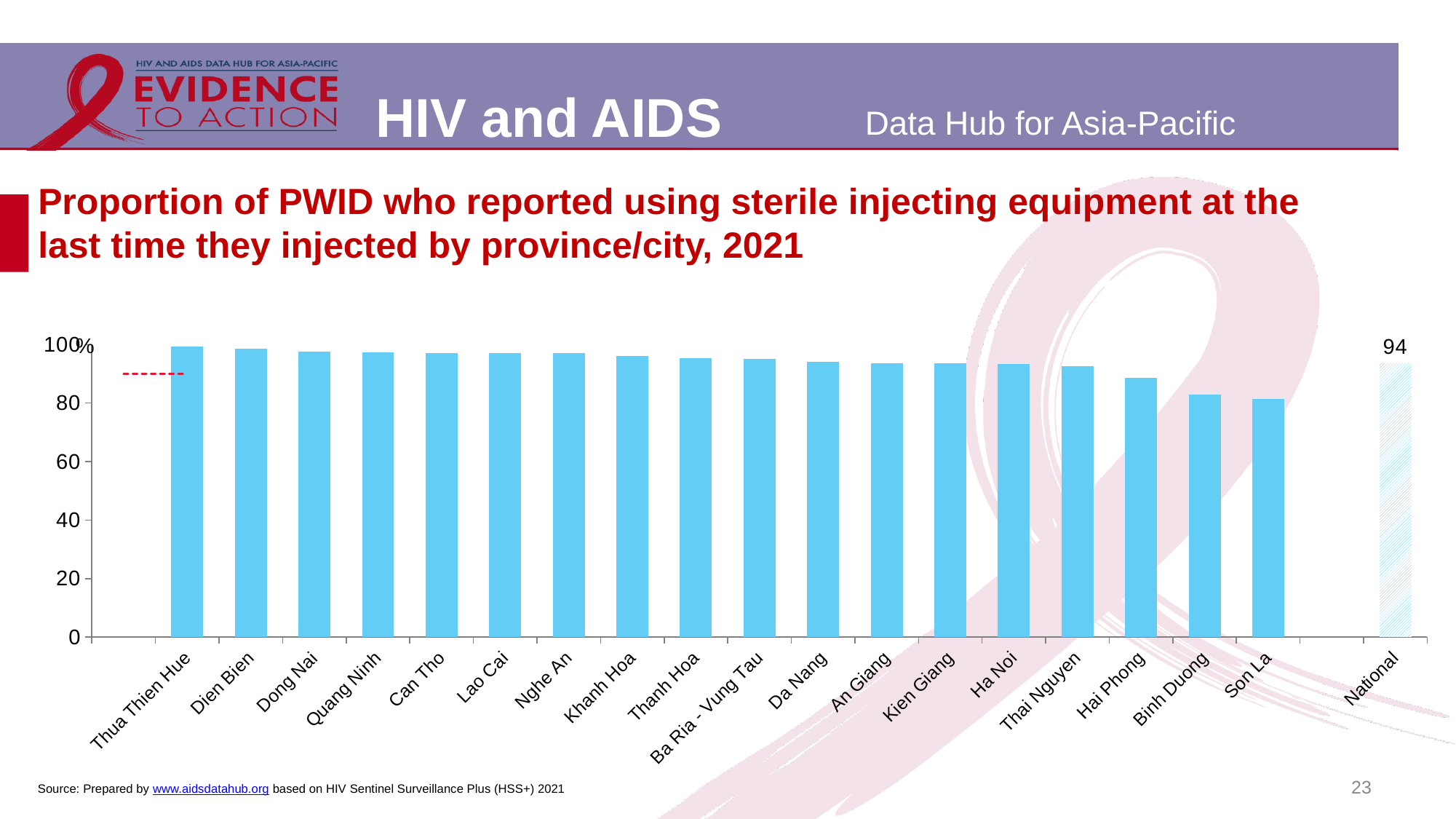
What kind of chart is shown on the slide? bar chart How many provinces/cities are shown in the chart, excluding National? 18 Is the value for Binh Duong greater or less than 80? greater How many bars are plotted in the chart, including National? 19 Is the value for Ha Noi greater or less than 80? greater What year does the chart title refer to? 2021 What is the value for National? 94 Do the province/city values rise or fall from left to right along the x axis? fall Which province/city has the lowest value? Son La Which is larger, the value for Thua Thien Hue or the value for Son La? Thua Thien Hue Is the value for Son La greater or less than 90? less